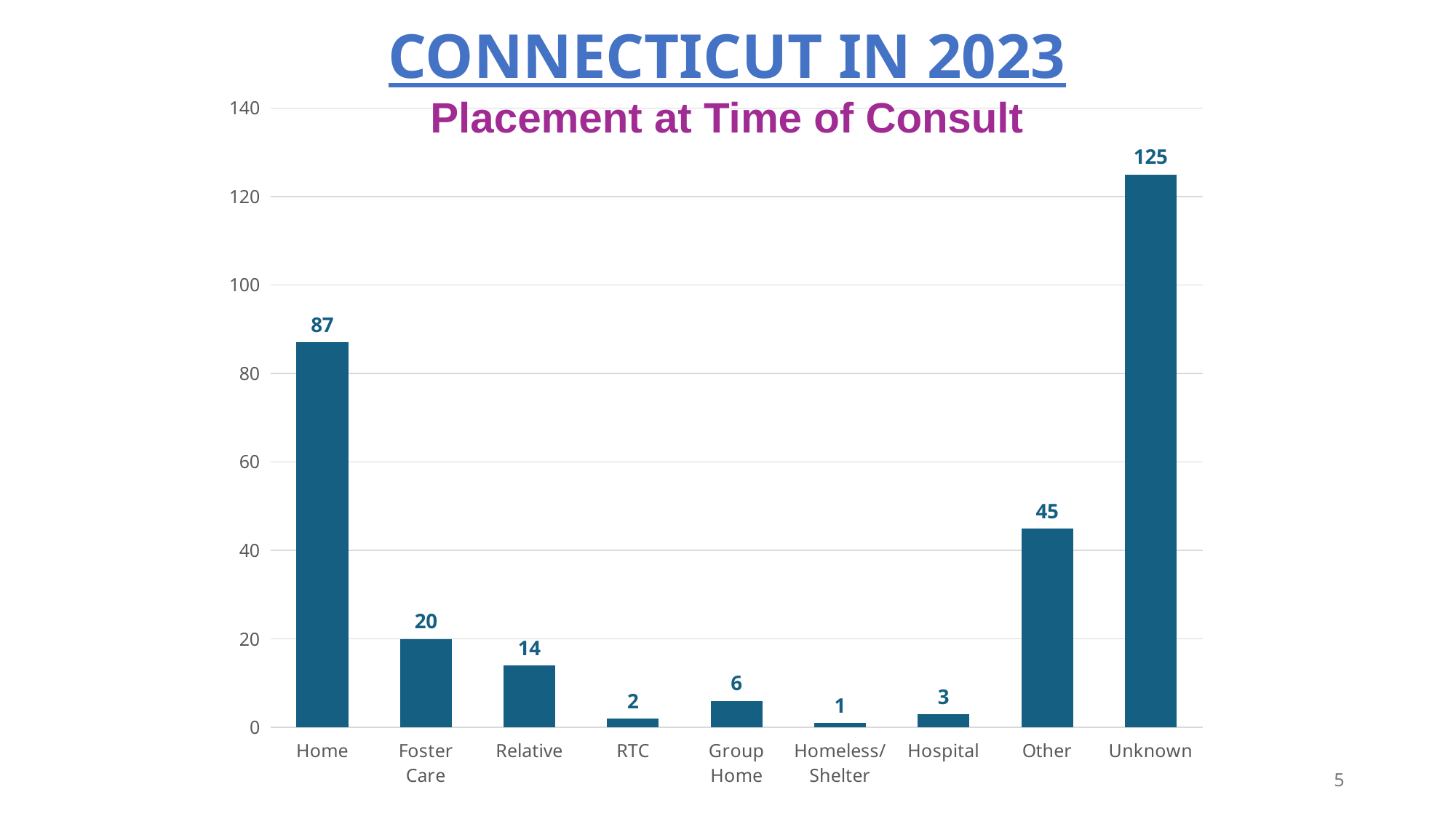
What is the subtitle of the chart shown below the main title? Placement at Time of Consult What is the value for Foster Care? 20 Which category has the lowest value? Homeless/Shelter What is the difference between the values for Unknown and Home? 38 What kind of chart is shown on the slide? Bar chart What is the difference between the values for Foster Care and Relative? 6 Which category has the highest value? Unknown What is the value for Home? 87 What is the value for Homeless/Shelter? 1 How many categories are shown on the x axis? 9 Which is larger, the value for Group Home or the value for Hospital? Group Home What is the value for Other? 45